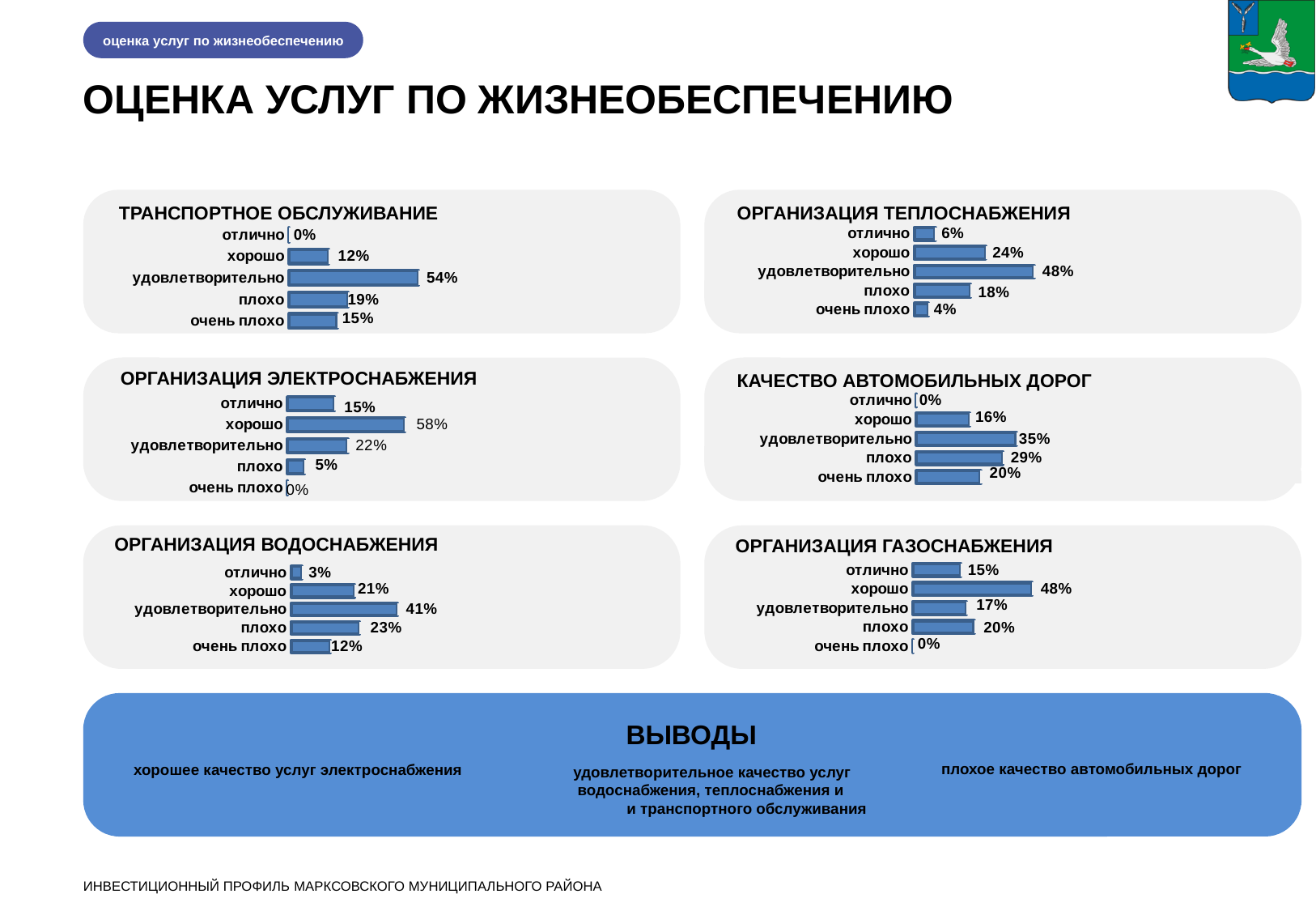
In the chart titled «ОРГАНИЗАЦИЯ ГАЗОСНАБЖЕНИЯ», which is larger: the value for «плохо» or the value for «удовлетворительно»? плохо In the chart titled «ОРГАНИЗАЦИЯ ГАЗОСНАБЖЕНИЯ», what is the value for «очень плохо»? 0% How many bar charts are shown on the slide? 6 In the chart titled «ОРГАНИЗАЦИЯ ВОДОСНАБЖЕНИЯ», what is the difference between the values for «удовлетворительно» and «плохо»? 18% In the chart titled «ОРГАНИЗАЦИЯ ВОДОСНАБЖЕНИЯ», which category has the highest value? удовлетворительно In the chart titled «ОРГАНИЗАЦИЯ ЭЛЕКТРОСНАБЖЕНИЯ», which category has the highest value? хорошо In the chart titled «КАЧЕСТВО АВТОМОБИЛЬНЫХ ДОРОГ», what is the difference between the values for «удовлетворительно» and «очень плохо»? 15% How many categories are shown in the chart titled «ОРГАНИЗАЦИЯ ТЕПЛОСНАБЖЕНИЯ»? 5 In the chart titled «ТРАНСПОРТНОЕ ОБСЛУЖИВАНИЕ», what is the value for «удовлетворительно»? 54% What kind of chart is used in the «ТРАНСПОРТНОЕ ОБСЛУЖИВАНИЕ» panel? Bar chart In the chart titled «КАЧЕСТВО АВТОМОБИЛЬНЫХ ДОРОГ», which category has the lowest value? отлично In the chart titled «ОРГАНИЗАЦИЯ ТЕПЛОСНАБЖЕНИЯ», what is the value for «хорошо»? 24%